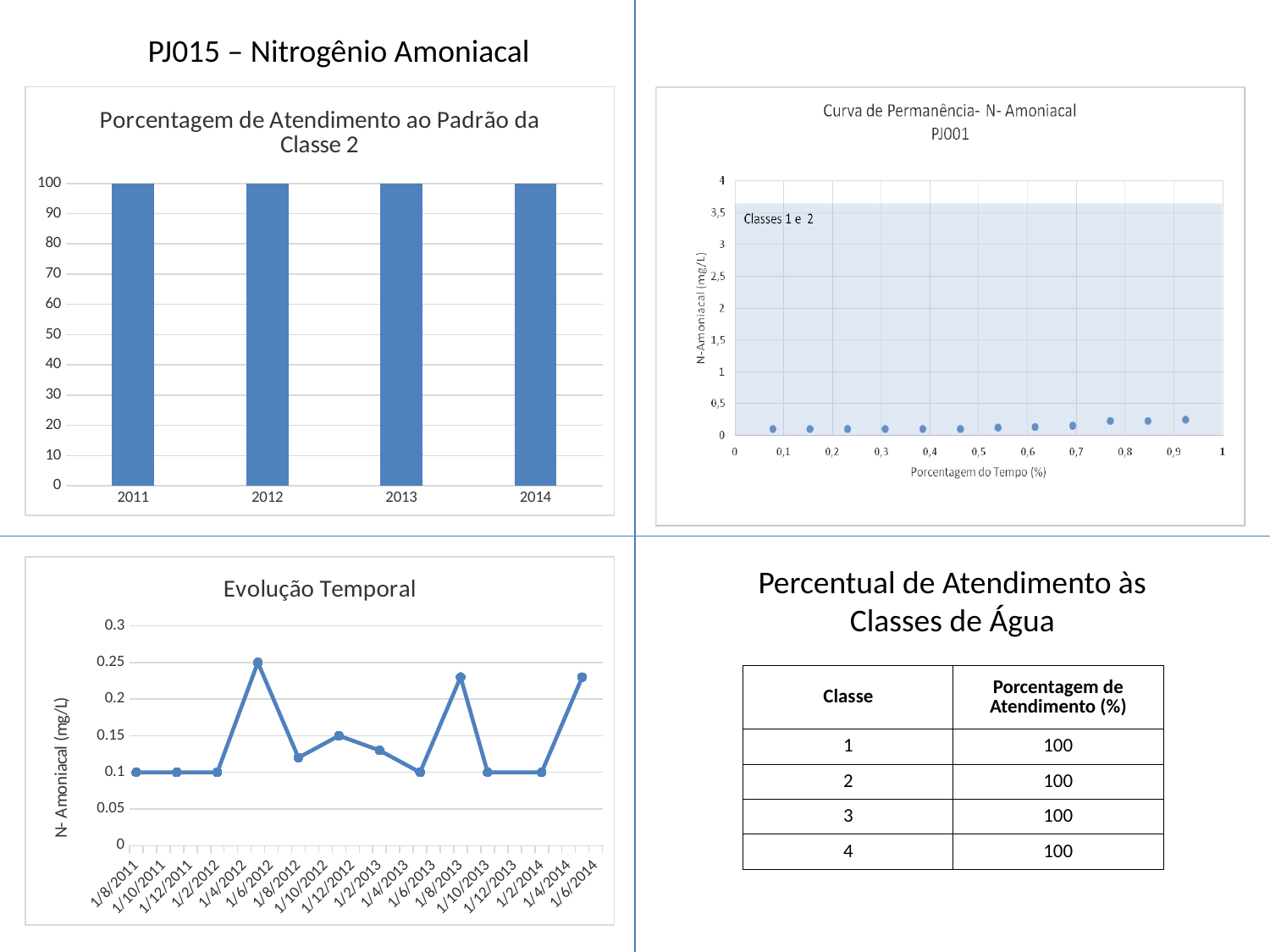
In the chart titled 'Porcentagem de Atendimento ao Padrão da Classe 2', do the values rise, fall, or stay the same from 2011 to 2014? stay the same In the chart titled 'Porcentagem de Atendimento ao Padrão da Classe 2', what is the value for 2014? 100 In the chart titled 'Porcentagem de Atendimento ao Padrão da Classe 2', what is the value for 2011? 100 How many categories are shown in the chart titled 'Porcentagem de Atendimento ao Padrão da Classe 2'? 4 What is the y-axis title of the chart titled 'Evolução Temporal'? N- Amoniacal (mg/L) What kind of chart is 'Porcentagem de Atendimento ao Padrão da Classe 2'? bar chart In the chart titled 'Curva de Permanência- N- Amoniacal PJ001', is the value at 0,9 on the x axis greater or less than 0,5? less